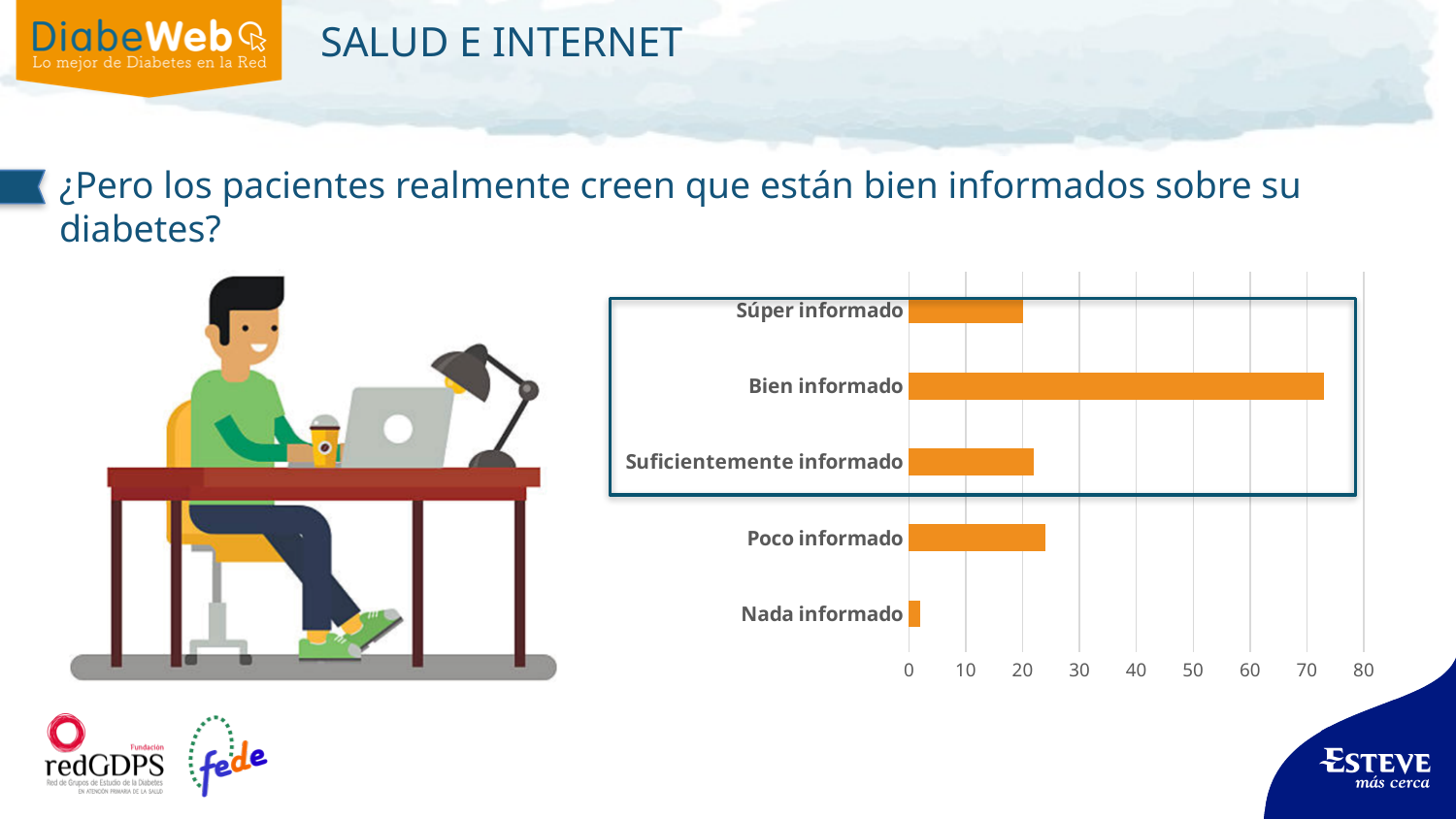
What kind of chart is shown on the slide? bar chart Is the value for Suficientemente informado greater or less than 30? less Is the value for Nada informado greater or less than 10? less Is the value for Bien informado greater or less than 70? greater Which is larger, the value for Bien informado or the value for Poco informado? Bien informado How many categories are plotted in the chart? 5 Which is larger, the value for Súper informado or the value for Nada informado? Súper informado What colour are the bars in the chart? orange Which category has the lowest value in the chart? Nada informado Which category has the highest value in the chart? Bien informado